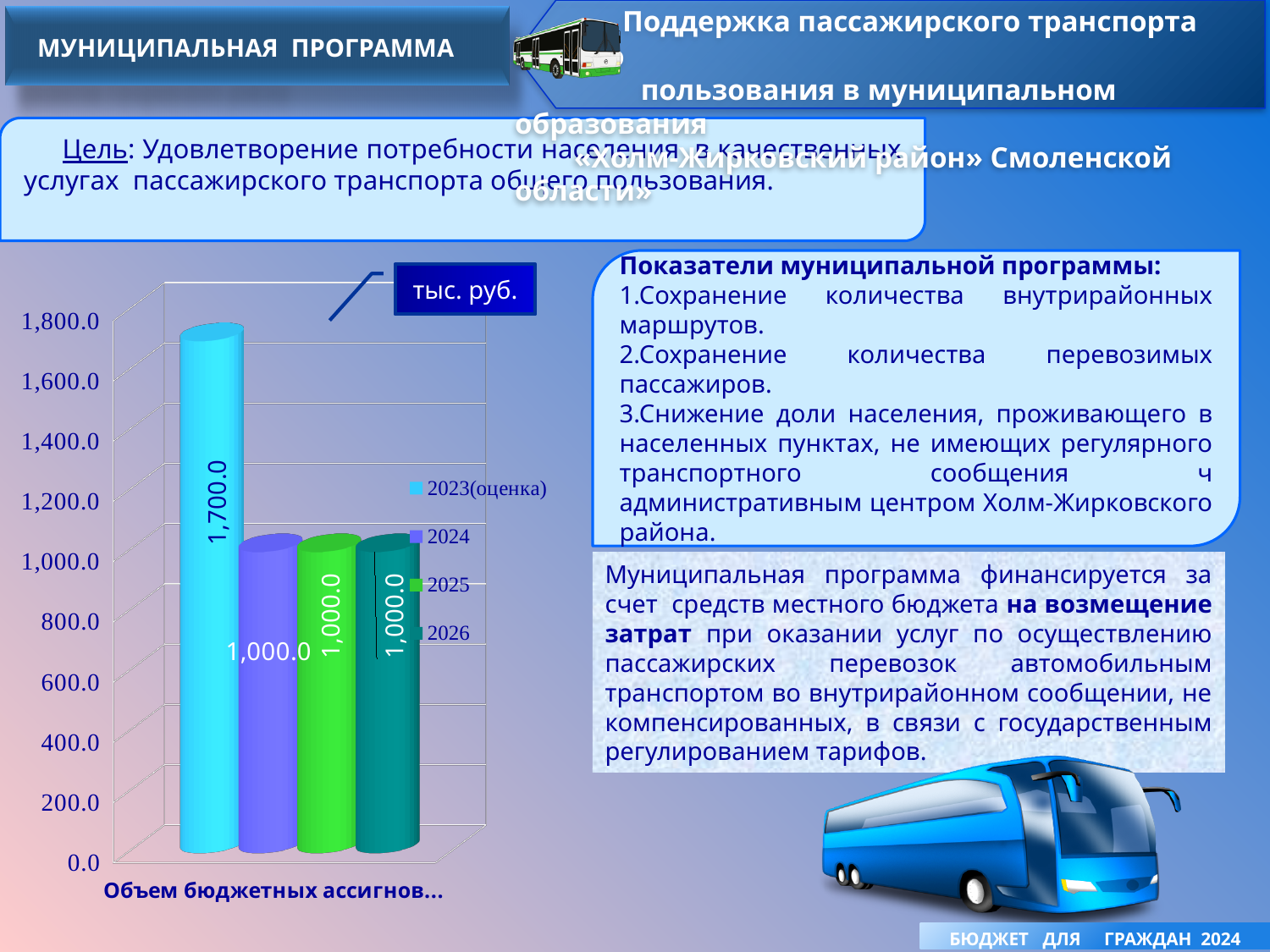
What is the value for 2026 in the chart? 1,000.0 Is the value for 2025 greater or less than 1,200.0? less Which is larger, the value for 2023(оценка) or the value for 2024? 2023(оценка) Which series has the highest value in the chart? 2023(оценка) What unit of measurement is shown in the box above the chart? тыс. руб. Is the value for 2023(оценка) greater or less than 1,600.0? greater What is the highest value shown on the chart's vertical axis? 1,800.0 How many series does the chart legend list? 4 What kind of chart is shown on the slide? bar chart What is the value for 2024 in the chart? 1,000.0 What is the value for 2023(оценка) in the chart? 1,700.0 What is the difference between the values for 2023(оценка) and 2025? 700.0